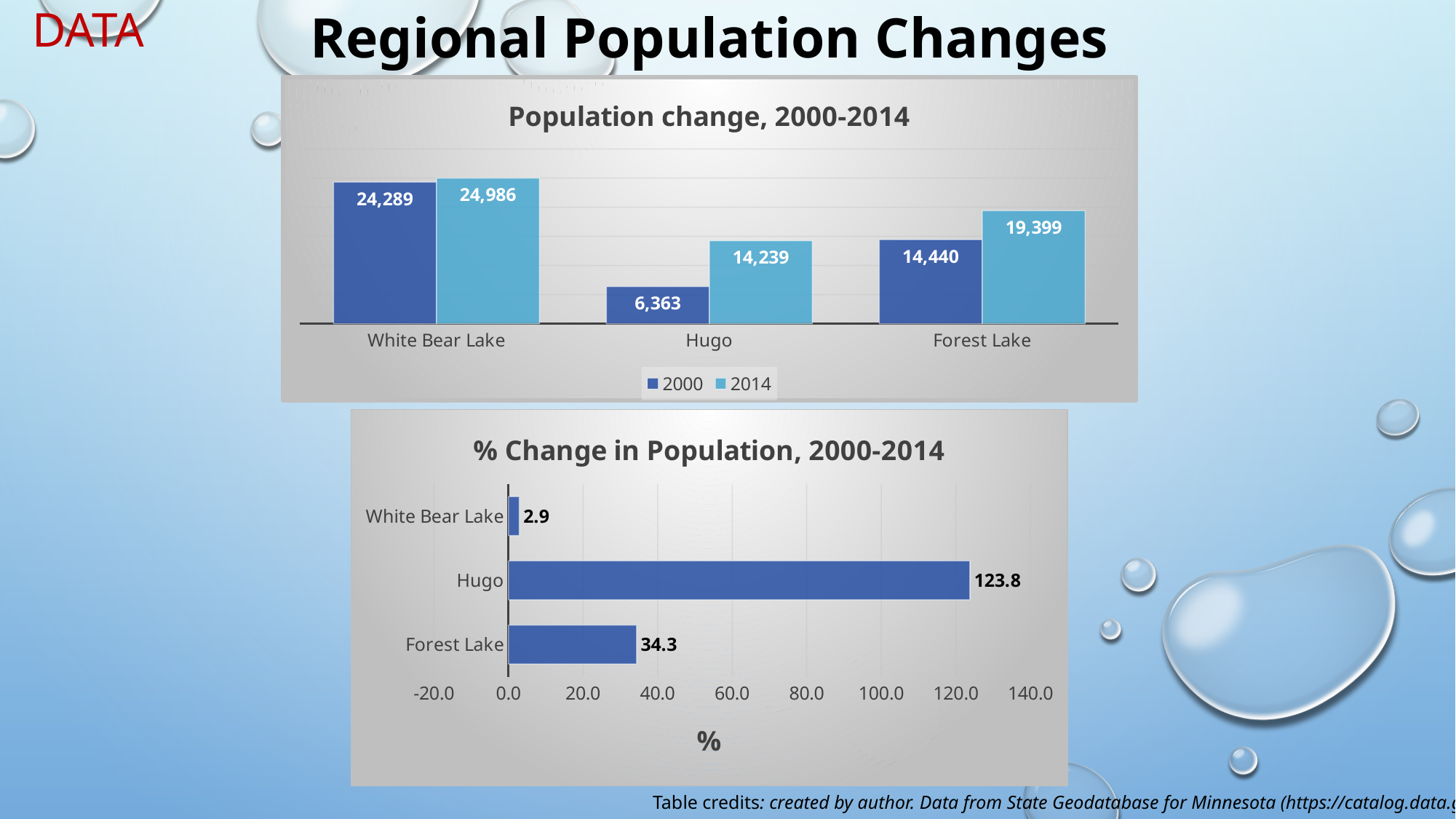
In the '% Change in Population, 2000-2014' chart, what is the value for Hugo? 123.8 In the '% Change in Population, 2000-2014' chart, what is the label on the horizontal axis? % In the 'Population change, 2000-2014' chart, how many cities are shown? 3 In the 'Population change, 2000-2014' chart, what was the population of Hugo in 2000? 6,363 What kind of chart is the '% Change in Population, 2000-2014' chart? Bar chart In the 'Population change, 2000-2014' chart, what is the difference between White Bear Lake's 2014 and 2000 populations? 697 In the '% Change in Population, 2000-2014' chart, which city has the lowest percentage change? White Bear Lake In the 'Population change, 2000-2014' chart, which city had the lowest population in 2000? Hugo In the '% Change in Population, 2000-2014' chart, what is the value for Forest Lake? 34.3 In the 'Population change, 2000-2014' chart, which city had the highest population in 2014? White Bear Lake In the 'Population change, 2000-2014' chart, how many series does the legend list? 2 In the 'Population change, 2000-2014' chart, what was the population of Forest Lake in 2014? 19,399